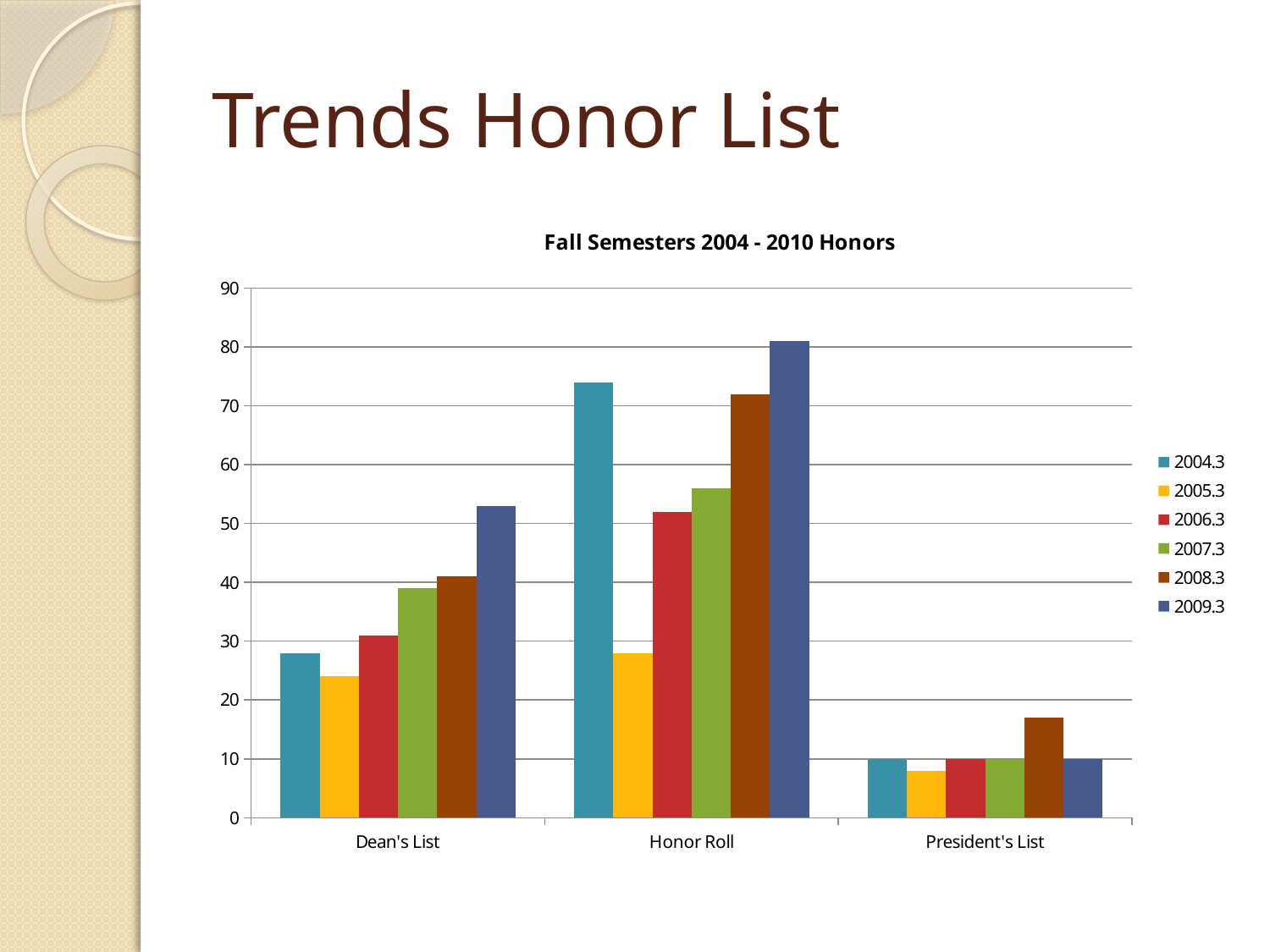
How many categories are shown on the x axis of the chart? 3 Which category contains the tallest bar in the chart? Honor Roll Is the value for 2009.3 in the Honor Roll category greater or less than 70? greater Which is larger: the 2009.3 value for Dean's List or the 2009.3 value for Honor Roll? Honor Roll How many series does the legend list? 6 Which series has the shortest bar in the Honor Roll category? 2005.3 Is the value for 2005.3 in the Dean's List category greater or less than 30? less What kind of chart is shown on the slide? bar chart What is the title of the chart? Fall Semesters 2004 - 2010 Honors Which series has the tallest bar in the Honor Roll category? 2009.3 Which series has the tallest bar in the Dean's List category? 2009.3 In the President's List category, which is larger: the 2008.3 value or the 2005.3 value? 2008.3